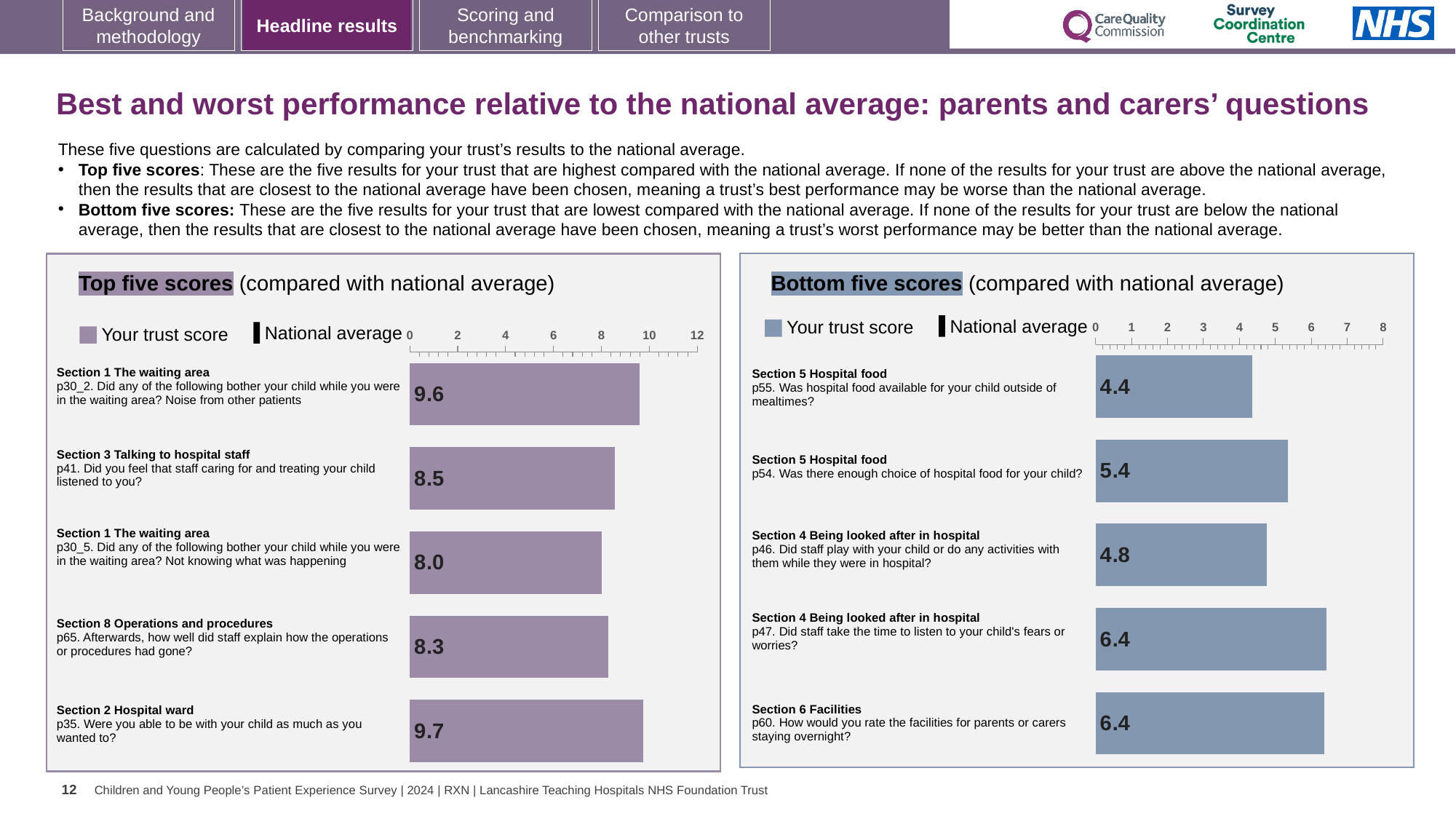
What two entries does the legend of the Top five scores chart list? Your trust score and National average In the Bottom five scores chart, is the trust score for p47 greater or less than 6? greater How many bars are plotted in the Top five scores chart? 5 In the Bottom five scores chart, what is the difference between the score for p47 and the score for p55? 2.0 In the Bottom five scores chart, what is the trust score for p46 (Did staff play with your child or do any activities with them while they were in hospital?)? 4.8 What type of chart is the Bottom five scores chart? Bar chart In the Bottom five scores chart, which question has the lowest trust score? p55. Was hospital food available for your child outside of mealtimes? In the Top five scores chart, which question has the highest trust score? p35. Were you able to be with your child as much as you wanted to? In the Top five scores chart, what is the trust score for p65 (how well did staff explain how the operations or procedures had gone)? 8.3 In the Bottom five scores chart, which has the larger trust score: p54 (enough choice of hospital food) or p46 (staff play with your child)? p54 In the Top five scores chart, what is the difference between the score for p35 and the score for p30_5? 1.7 In the Top five scores chart, what is the trust score for p41 (Did you feel that staff caring for and treating your child listened to you?)? 8.5